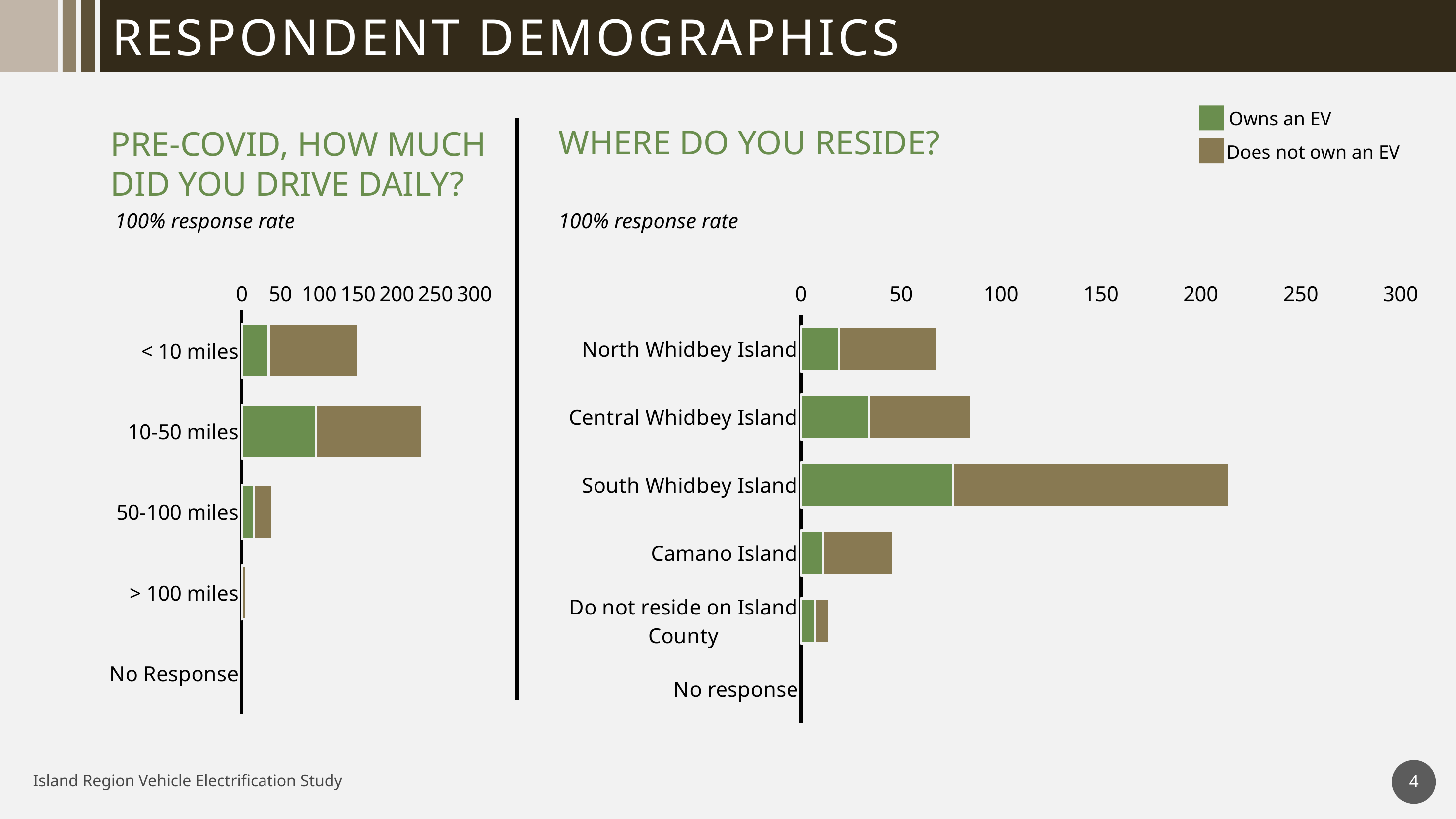
In the "Where do you reside?" chart, which has the longer total bar, North Whidbey Island or Central Whidbey Island? Central Whidbey Island Which legend entry is shown in green? Owns an EV In the "Where do you reside?" chart, how many categories are shown on the y axis? 6 In the "Where do you reside?" chart, which category has the longest total bar? South Whidbey Island In the "Where do you reside?" chart, is the total bar for South Whidbey Island greater or less than 200? greater How many series does the legend list? 2 In the "Pre-COVID, how much did you drive daily?" chart, is the total bar for 50-100 miles greater or less than 50? less What kind of chart is the "Where do you reside?" chart? Bar chart In the "Pre-COVID, how much did you drive daily?" chart, is the total bar for 10-50 miles greater or less than 200? greater In the "Pre-COVID, how much did you drive daily?" chart, which category has the longest total bar? 10-50 miles In the "Pre-COVID, how much did you drive daily?" chart, how many categories are shown on the y axis? 5